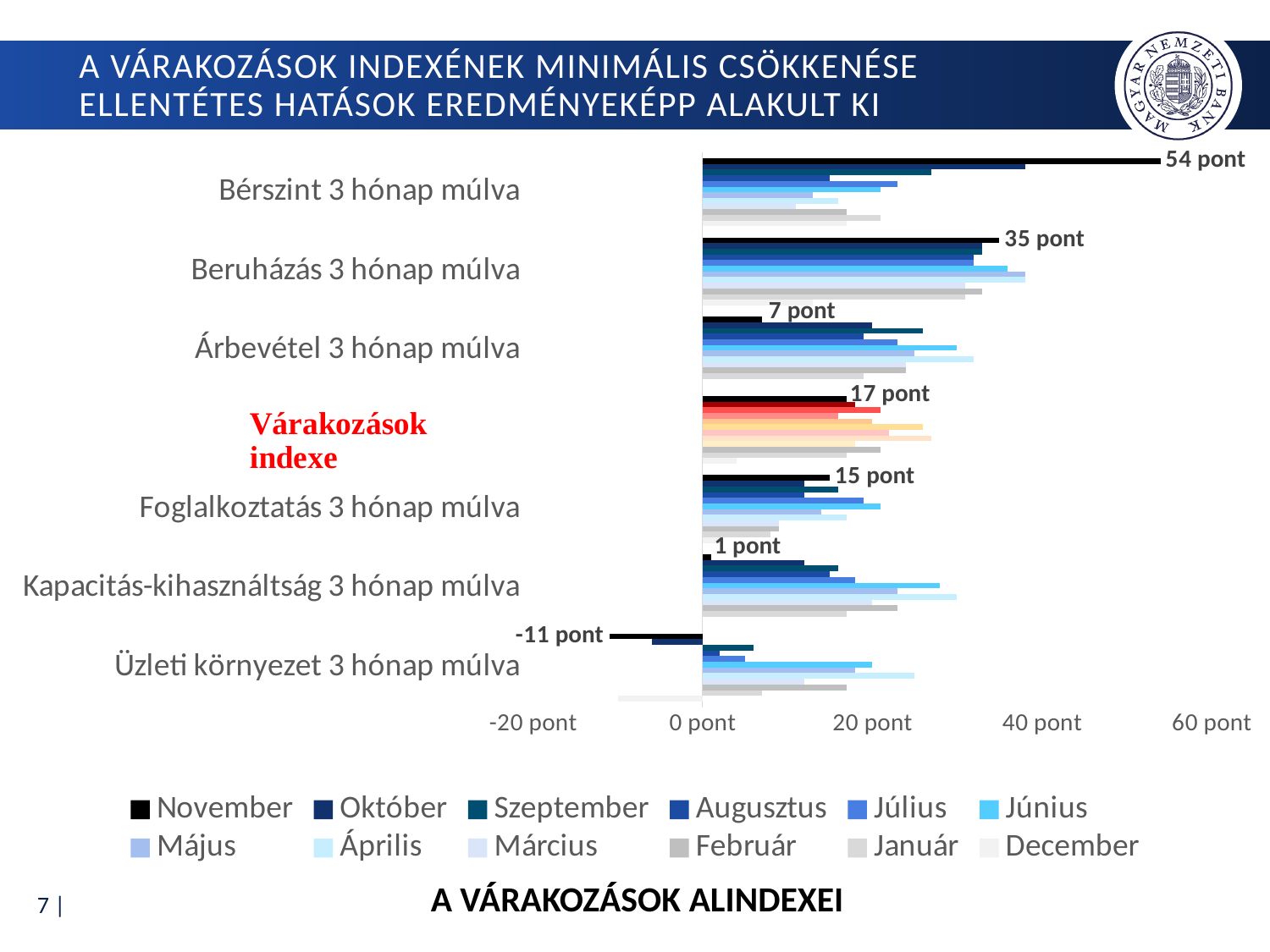
Which category has the lowest November value? Üzleti környezet 3 hónap múlva How many series does the legend list? 12 How many categories are shown on the chart? 7 What is the November value for Üzleti környezet 3 hónap múlva? -11 pont What is the November value for Várakozások indexe? 17 pont What is the November value for Kapacitás-kihasználtság 3 hónap múlva? 1 pont Which has the larger November value: Várakozások indexe or Foglalkoztatás 3 hónap múlva? Várakozások indexe What is the difference between the November values for Bérszint 3 hónap múlva and Beruházás 3 hónap múlva? 19 pont What kind of chart is shown on the slide? bar chart What is the November value for Bérszint 3 hónap múlva? 54 pont Which category has the highest November value? Bérszint 3 hónap múlva Is the Június value for Beruházás 3 hónap múlva greater or less than 20 pont? greater